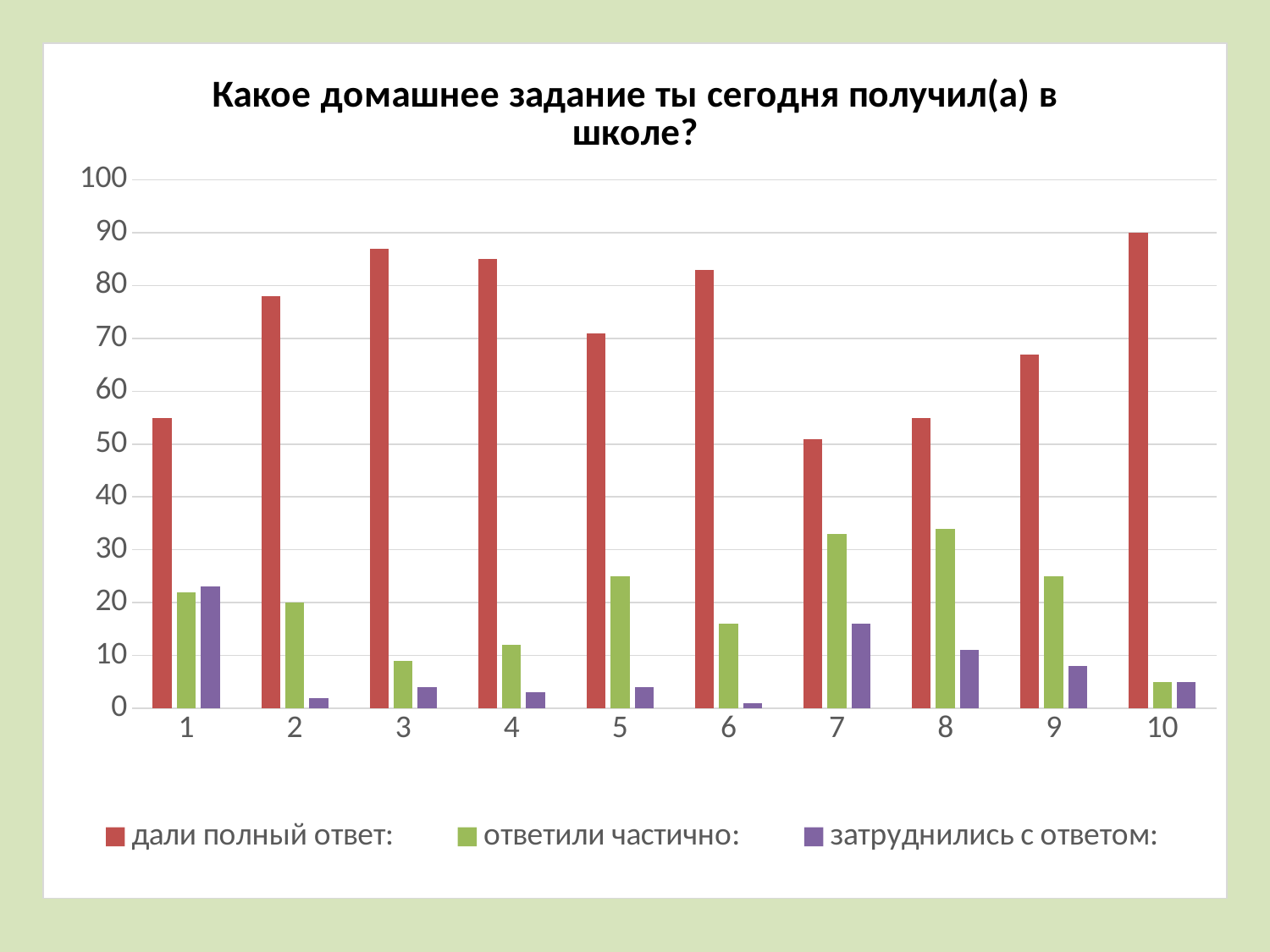
What kind of chart is shown on the slide? bar chart Is the value for "дали полный ответ:" in category 3 greater or less than 80? greater Which series is shown in purple according to the legend? затруднились с ответом: Is the value for "ответили частично:" in category 7 greater or less than 30? greater Which is larger: the value for "ответили частично:" in category 7 or in category 2? category 7 Is the value for "затруднились с ответом:" in category 2 greater or less than 10? less What is the title of the chart? Какое домашнее задание ты сегодня получил(а) в школе? How many categories are shown along the x axis? 10 Which is larger: the value for "дали полный ответ:" in category 3 or in category 1? category 3 Which category has the highest value for "затруднились с ответом:"? 1 How many series does the legend list? 3